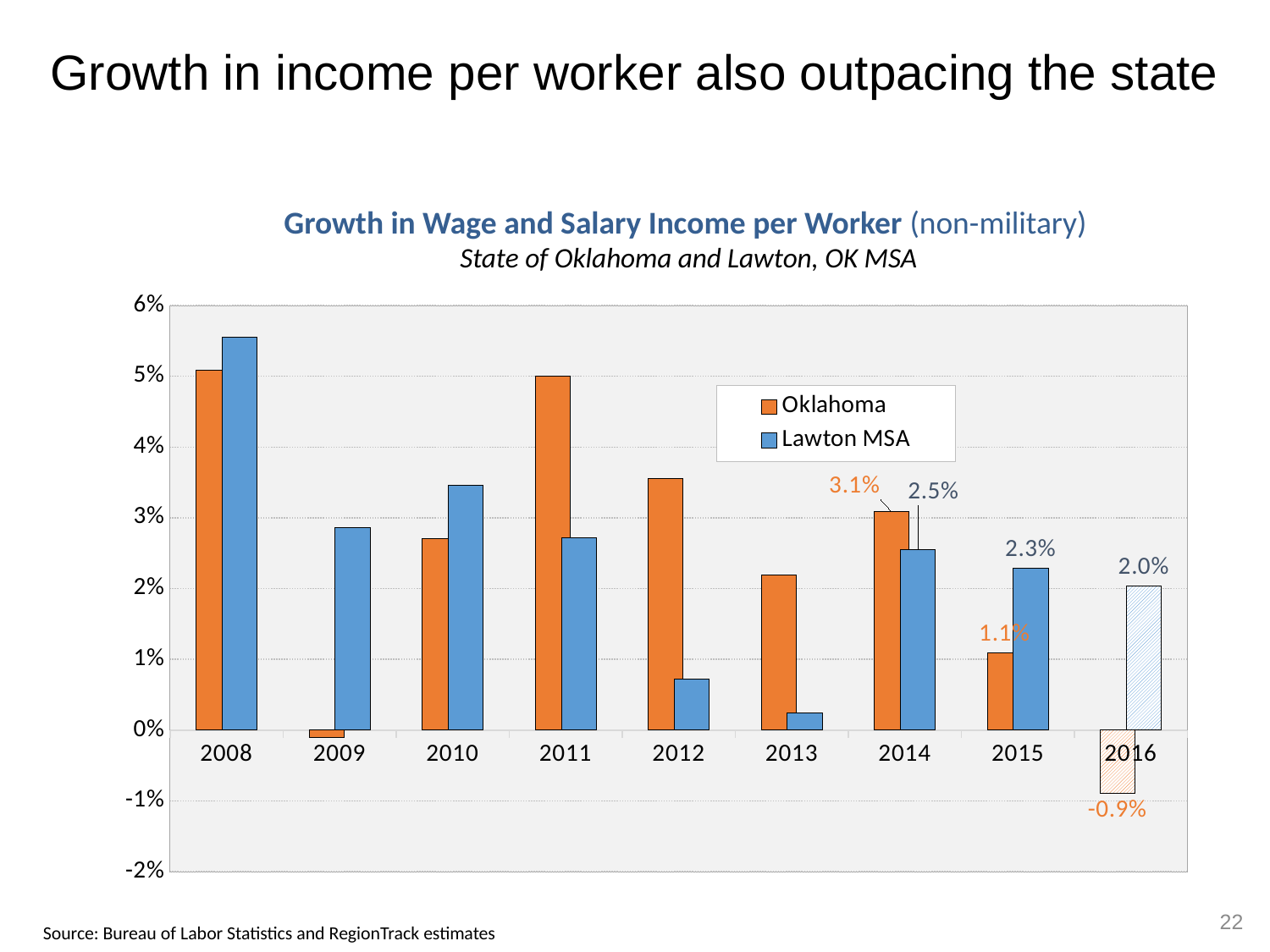
What is the Oklahoma value for 2014? 3.1% What is the Oklahoma value for 2016? -0.9% In 2015, how much higher is the Lawton MSA value than the Oklahoma value? 1.2 percentage points In which year is the Lawton MSA value highest? 2008 What is the Lawton MSA value for 2016? 2.0% How many series does the legend list? 2 What is the Lawton MSA value for 2015? 2.3% How many years are shown on the x axis? 9 Is the Lawton MSA value for 2008 greater or less than 5%? greater Is the Oklahoma value for 2012 greater or less than 3%? greater In which year is the Oklahoma value lowest? 2016 In 2014, which series has the larger value, Oklahoma or Lawton MSA? Oklahoma